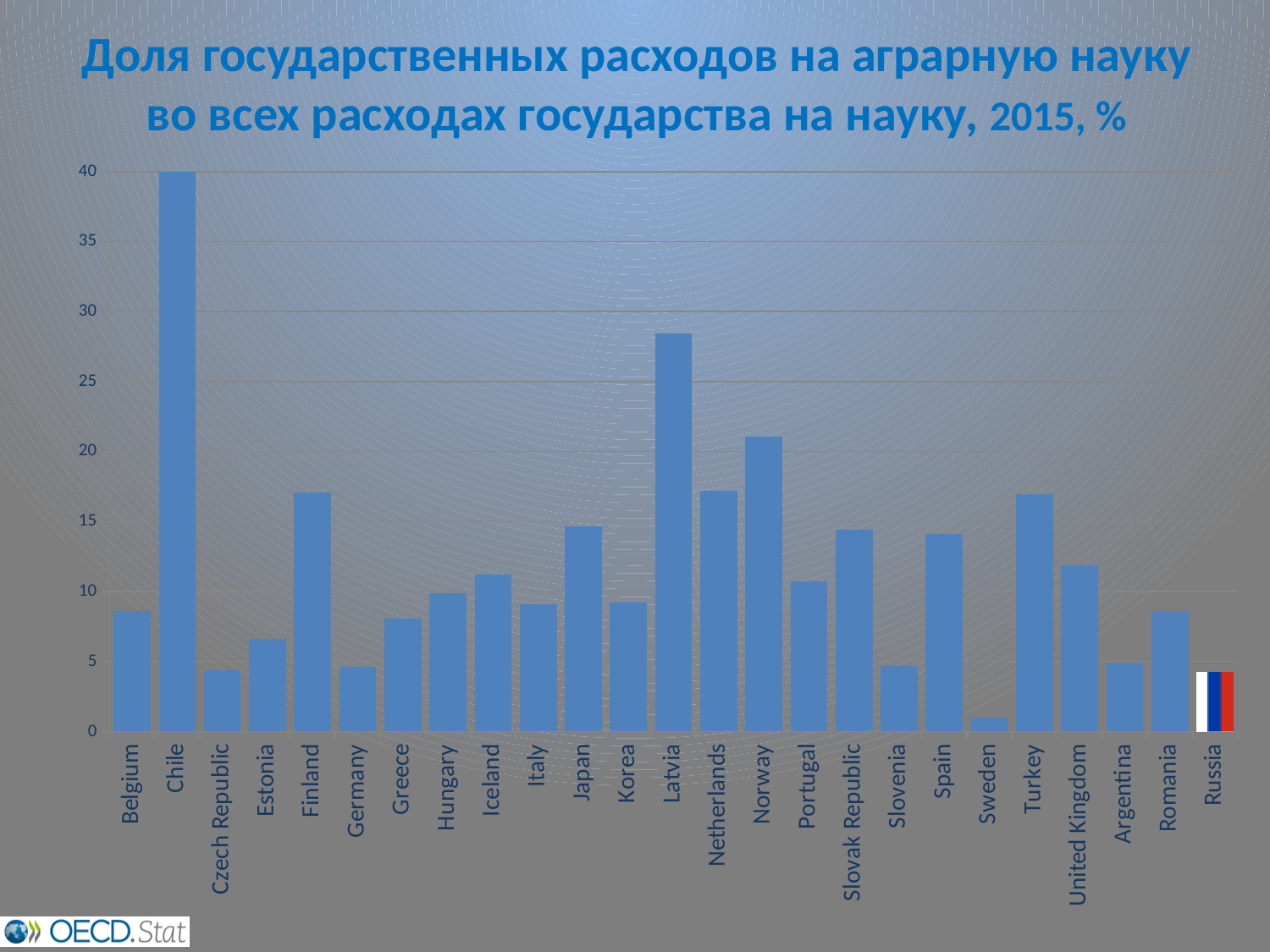
What kind of chart is shown on the slide? bar chart Is the value for Sweden greater or less than 5? less Which country has the highest share of public spending on agricultural science? Chile Which country's bar is coloured differently from the others (in white, blue and red)? Russia Which country has the lowest share of public spending on agricultural science? Sweden Is the value for Latvia greater or less than 25? greater How many countries are shown on the chart? 25 Which is larger, the value for Latvia or the value for Norway? Latvia Which is larger, the value for Netherlands or the value for Norway? Norway Is the value for Iceland greater or less than 10? greater